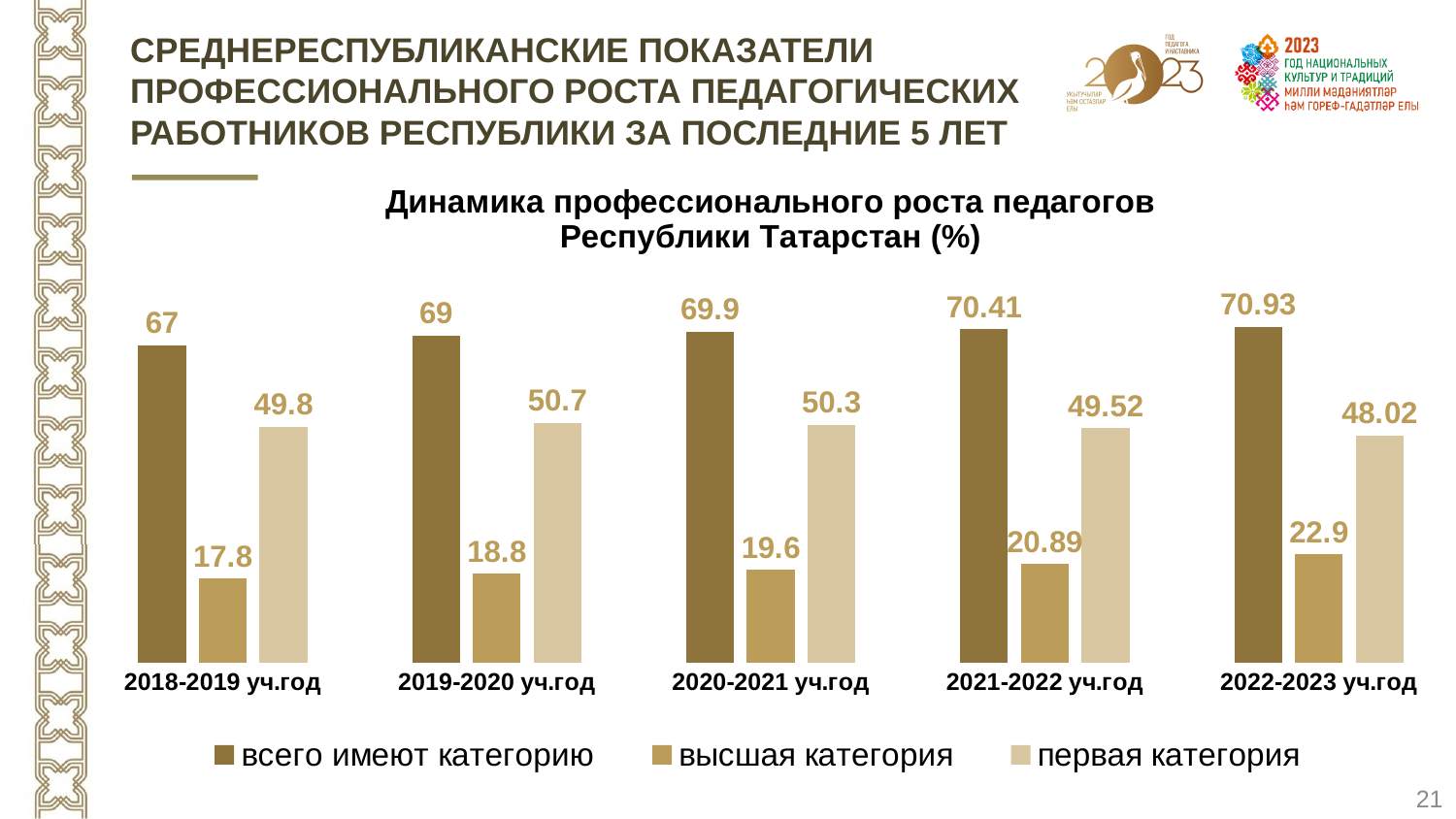
In which academic year is the value for "высшая категория" highest? 2022-2023 уч.год What is the title of the chart? Динамика профессионального роста педагогов Республики Татарстан (%) In which academic year is the value for "первая категория" lowest? 2022-2023 уч.год How many academic years are shown on the x axis? 5 Do the values for "всего имеют категорию" rise or fall from 2018-2019 уч.год to 2022-2023 уч.год? Rise How many series does the legend list? 3 What kind of chart is shown on the slide? Bar chart What is the value for "всего имеют категорию" in 2022-2023 уч.год? 70.93 What is the value for "высшая категория" in 2018-2019 уч.год? 17.8 What is the difference between the "всего имеют категорию" values for 2022-2023 уч.год and 2018-2019 уч.год? 3.93 What is the value for "первая категория" in 2020-2021 уч.год? 50.3 Which is larger: "первая категория" in 2019-2020 уч.год or "первая категория" in 2021-2022 уч.год? 2019-2020 уч.год